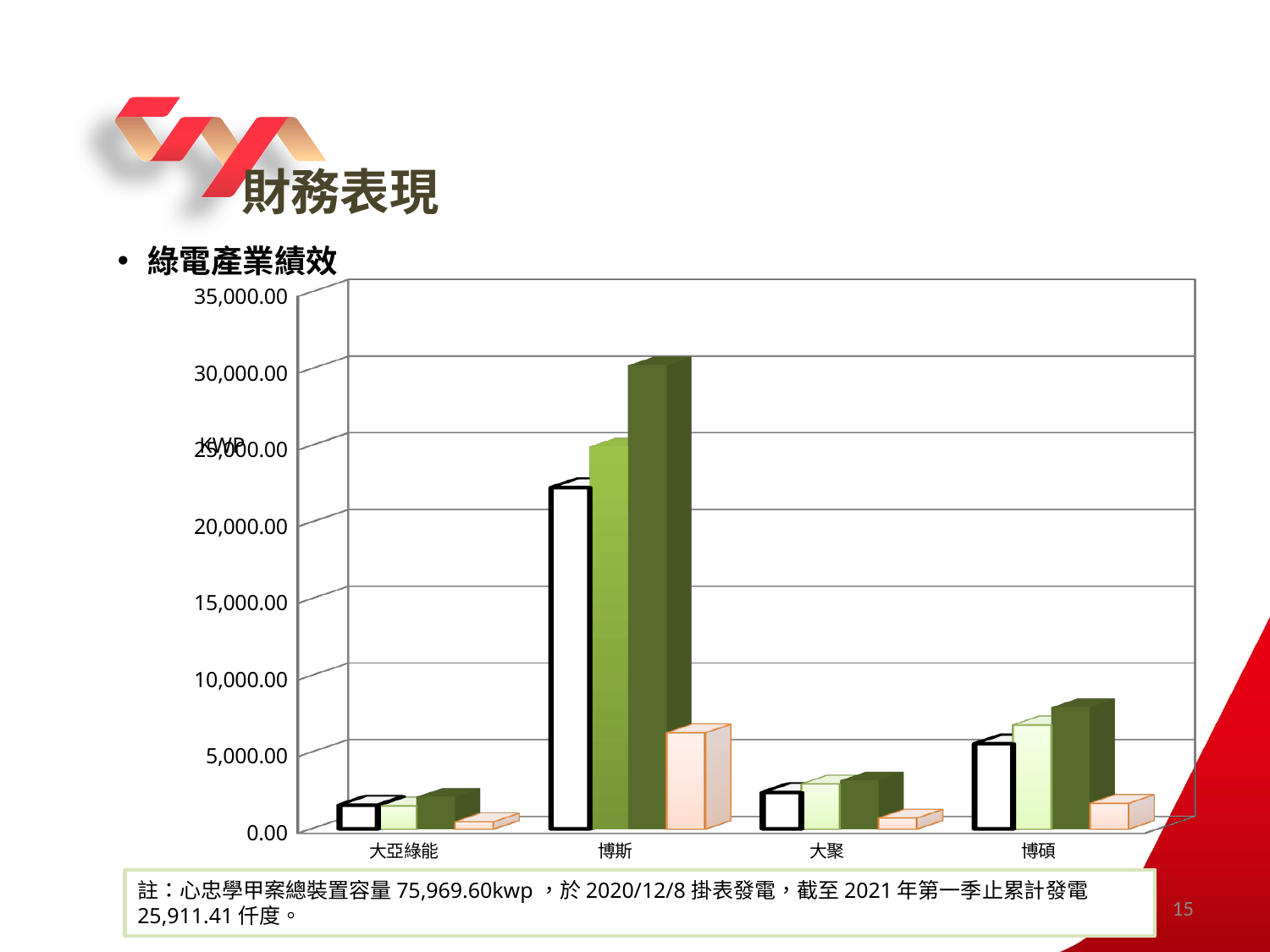
What is the highest value shown on the y axis of the chart? 35,000.00 How many categories are shown on the x axis of the chart? 4 Is the value of the tallest (dark green) bar for 博斯 greater or less than 25,000.00? greater What is the label of the last category on the x axis of the chart? 博碩 Is the value of the dark green bar for 博碩 greater or less than 10,000.00? less What kind of chart is shown on the slide? bar chart Which is larger, the dark green bar for 博斯 or the dark green bar for 博碩? 博斯 Which category has the tallest bars in the chart? 博斯 Is the value of the white bar for 博斯 greater or less than 25,000.00? less How many bars are plotted for each category in the chart? 4